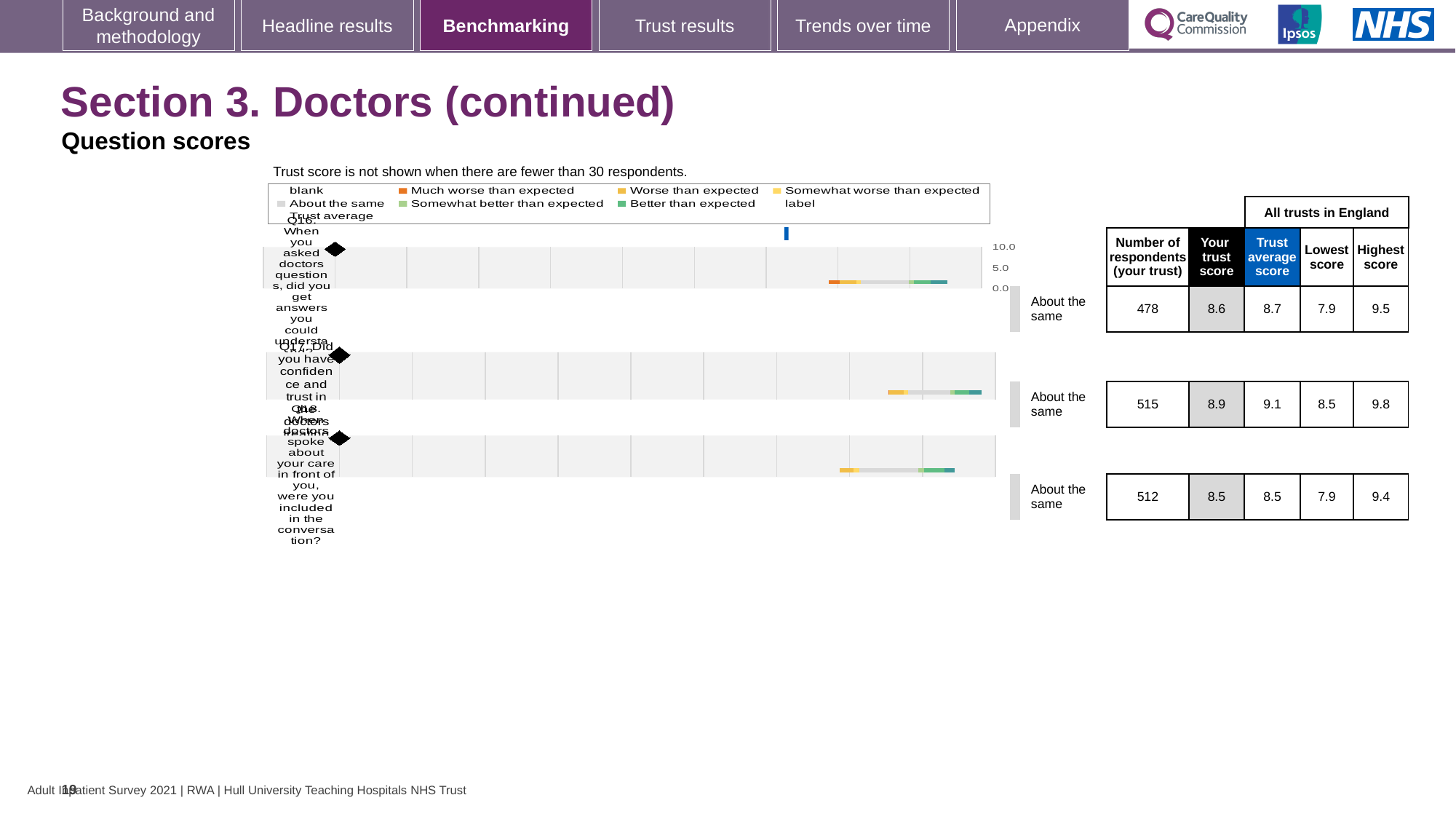
What is the trust score for Q16 (When you asked doctors questions, did you get answers you could understand)? 8.6 What kind of chart is used to show the question scores on this slide? bar chart What benchmark category is shown for all three questions? About the same What is the trust average score for Q17 (Did you have confidence and trust in the doctors)? 9.1 How many respondents from the trust answered Q17? 515 Which question has the lowest trust score? Q18 What is the difference between the highest score and the lowest score for Q17? 1.3 Which question has the highest trust score? Q17 What is the highest score across all trusts in England for Q18? 9.4 For Q16, which is larger: the trust score or the trust average score? trust average score How many questions are plotted in the chart? 3